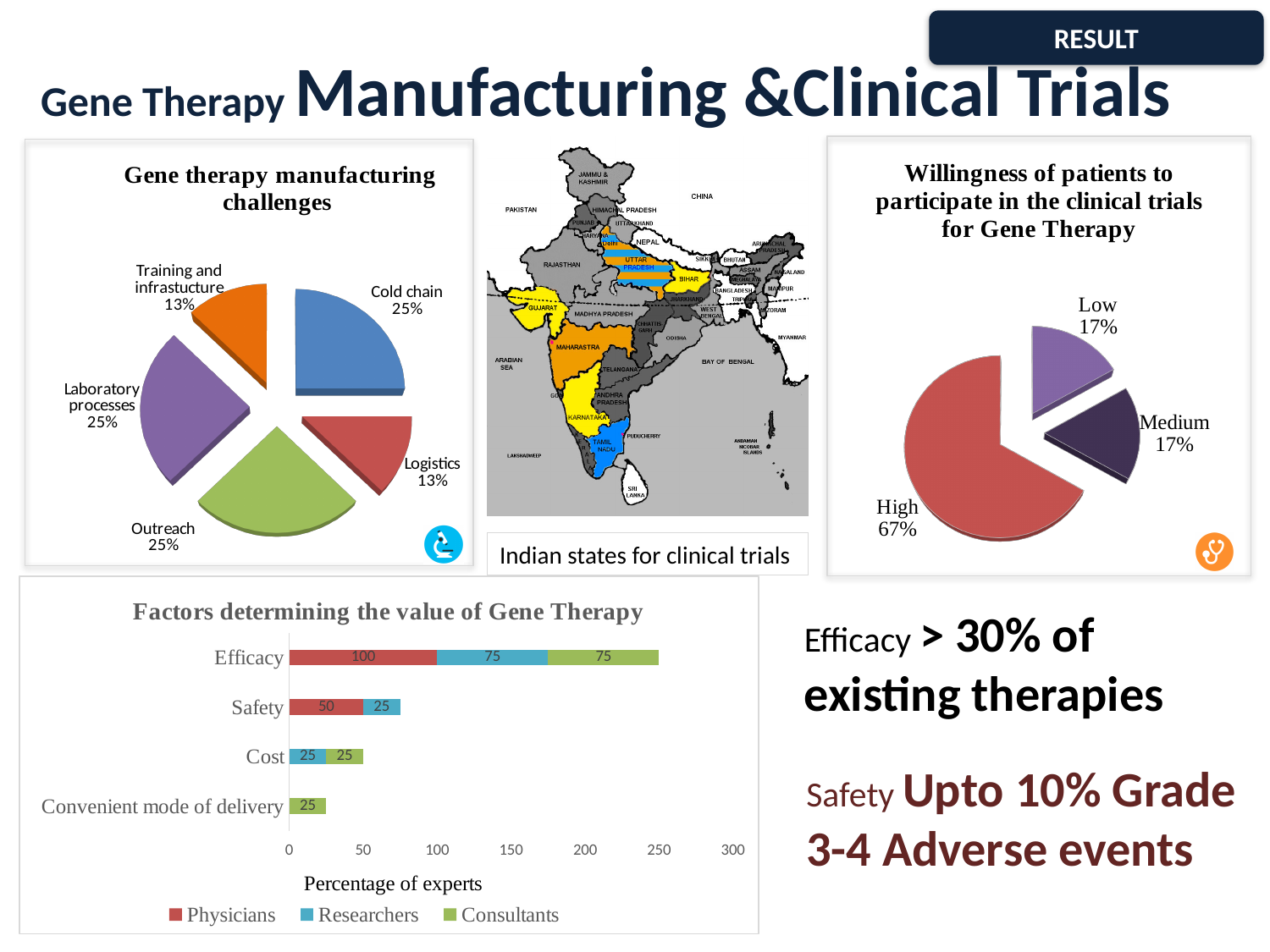
In the 'Factors determining the value of Gene Therapy' chart, what is the Physicians value for Efficacy? 100 In the 'Gene therapy manufacturing challenges' pie chart, what share does Cold chain have? 25% How many slices does the 'Gene therapy manufacturing challenges' pie chart have? 5 In the 'Willingness of patients to participate in the clinical trials for Gene Therapy' pie chart, which category has the largest share? High In the 'Factors determining the value of Gene Therapy' chart, what is the total of the stacked bar for Efficacy? 250 In the 'Factors determining the value of Gene Therapy' chart, how many series does the legend list? 3 In the 'Factors determining the value of Gene Therapy' chart, what is the difference between the Physicians value for Efficacy and the Physicians value for Safety? 50 What kind of chart is 'Willingness of patients to participate in the clinical trials for Gene Therapy'? Pie chart In the 'Willingness of patients to participate in the clinical trials for Gene Therapy' pie chart, what share does Medium have? 17% In the 'Gene therapy manufacturing challenges' pie chart, what share does Logistics have? 13% In the 'Factors determining the value of Gene Therapy' chart, what is the total of the stacked bar for Safety? 75 What kind of chart is 'Factors determining the value of Gene Therapy'? Bar chart